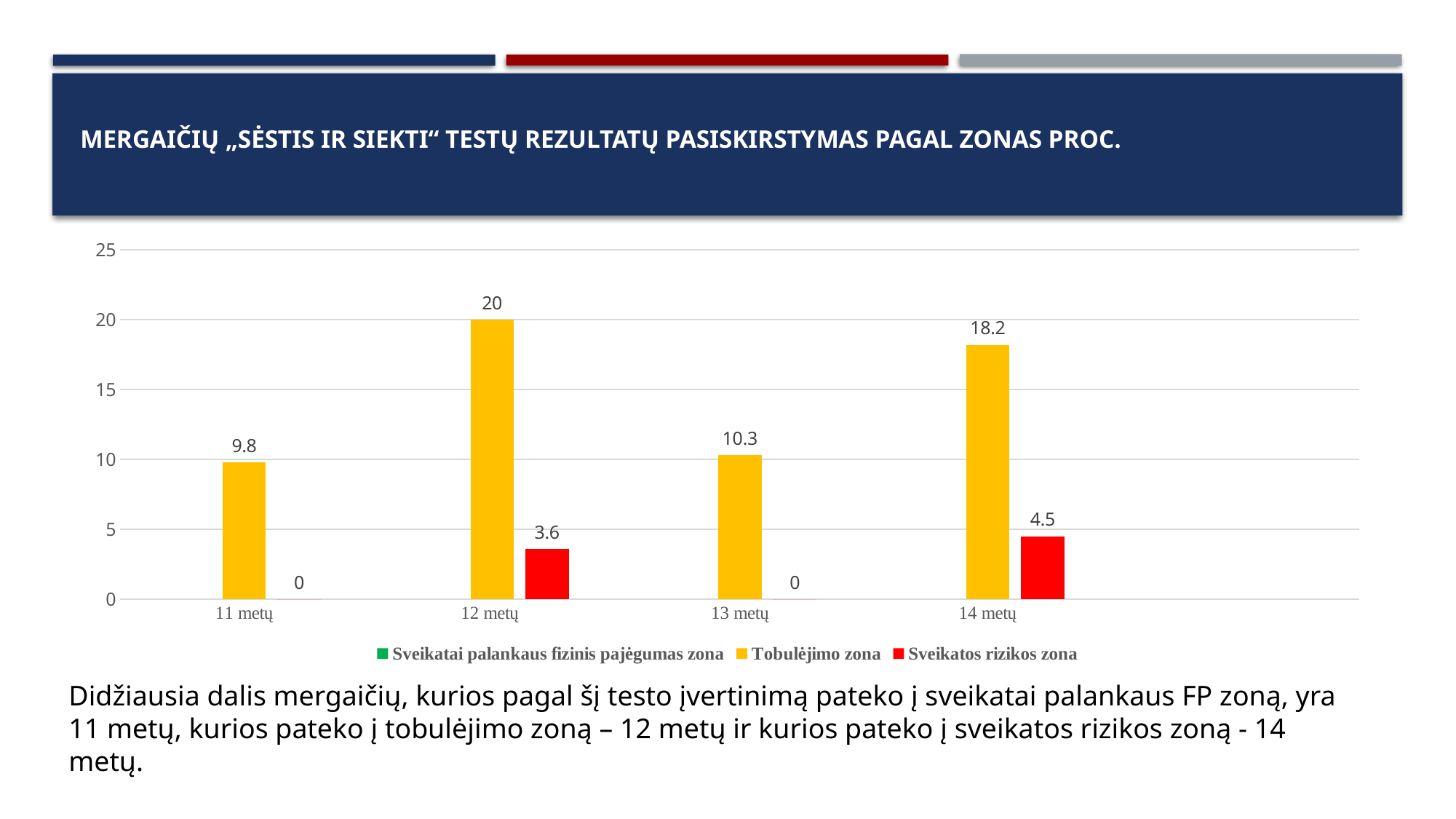
What is the value of Sveikatos rizikos zona for 14 metų? 4.5 What is the value of Sveikatos rizikos zona for 13 metų? 0 What kind of chart is shown on the slide? Bar chart What is the value of Tobulėjimo zona for 12 metų? 20 What is the value of Tobulėjimo zona for 11 metų? 9.8 How many age groups are shown on the x axis? 4 Which age group has the highest value for Tobulėjimo zona? 12 metų How many series does the legend list? 3 Which age group has the lowest value for Tobulėjimo zona? 11 metų What is the difference between the Tobulėjimo zona values for 12 metų and 14 metų? 1.8 Which is larger, the Tobulėjimo zona value for 13 metų or for 11 metų? 13 metų What is the difference between the Sveikatos rizikos zona values for 14 metų and 12 metų? 0.9